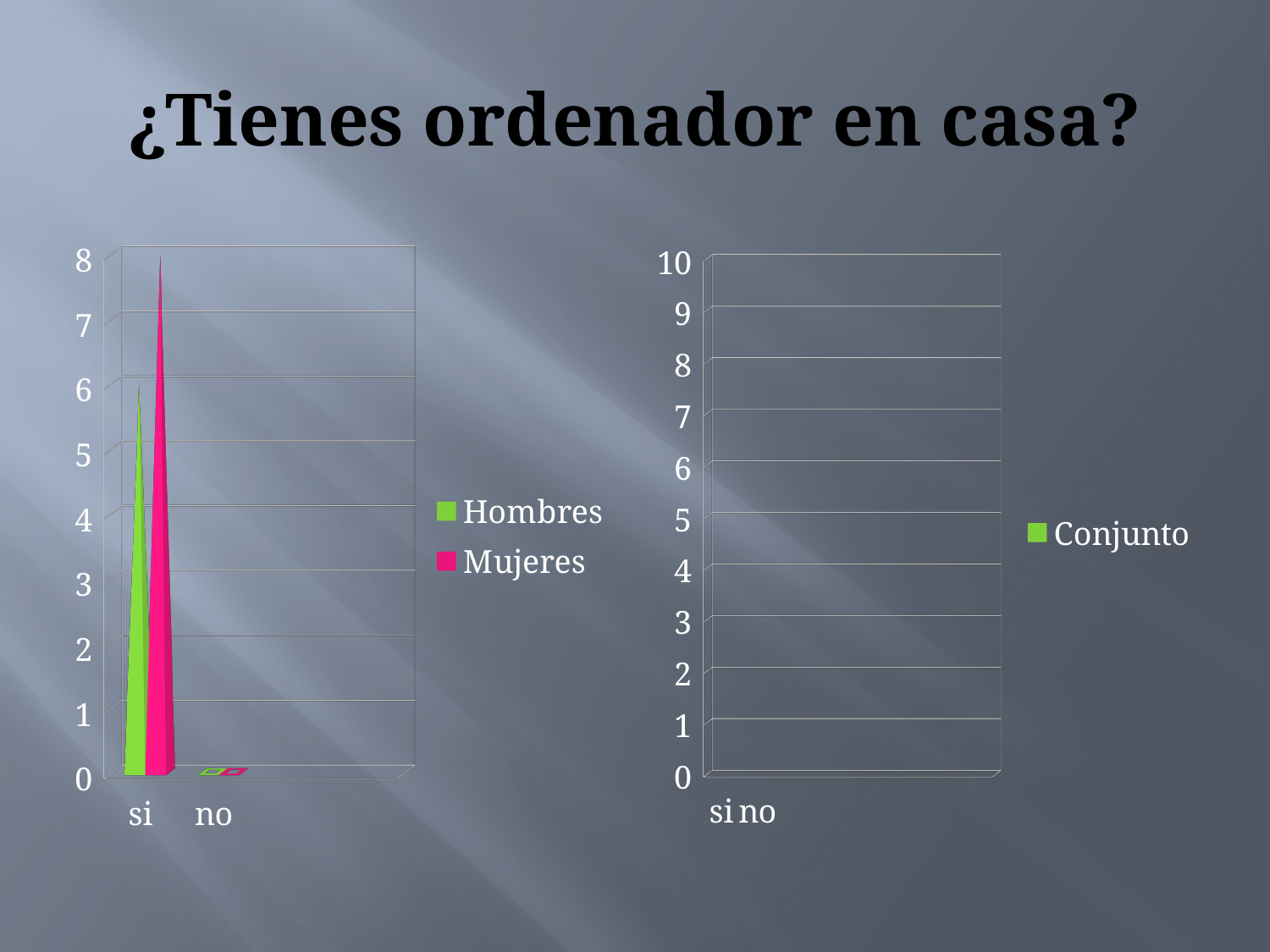
How many series does the legend of the left chart list? 2 In the left chart, is the value for Hombres in the "no" category greater or less than 1? less In the left chart, which category has the highest value for Mujeres? si What is the name of the series in the legend of the right chart? Conjunto In the left chart, is the value for Hombres in the "si" category greater or less than 3? greater What are the two series named in the legend of the left chart? Hombres and Mujeres In the left chart, is the value for Mujeres in the "si" category greater or less than 4? greater In the left chart, which category has the lowest value for Hombres? no How many categories are shown on the x axis of the left chart? 2 How many series does the legend of the right chart list? 1 In the left chart, for the category "si", which series has the larger value, Hombres or Mujeres? Mujeres What kind of chart is the left chart on the slide? bar chart